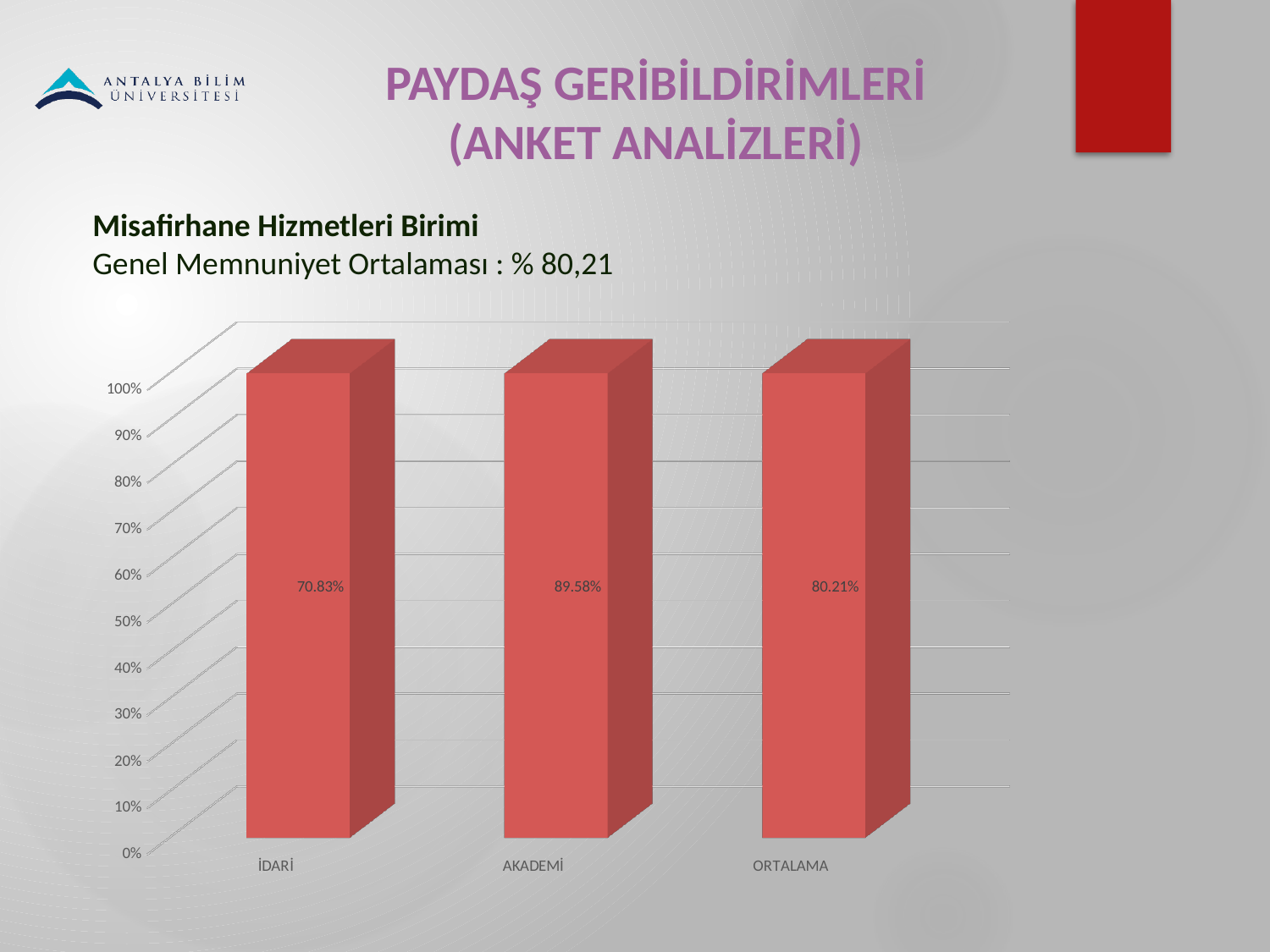
Which category has the lowest value? İDARİ What is the difference between the AKADEMİ and İDARİ values? 18.75% What is the highest value labelled on the vertical axis? 100% What is the value shown for ORTALAMA? 80.21% What is the value shown for İDARİ? 70.83% What kind of chart is shown on the slide? Bar chart What is the value shown for AKADEMİ? 89.58% Which is larger, the value for İDARİ or the value for AKADEMİ? AKADEMİ What is the difference between the AKADEMİ and ORTALAMA values? 9.37% Which is larger, the value for ORTALAMA or the value for İDARİ? ORTALAMA How many categories are shown on the x axis? 3 Which category has the highest value? AKADEMİ